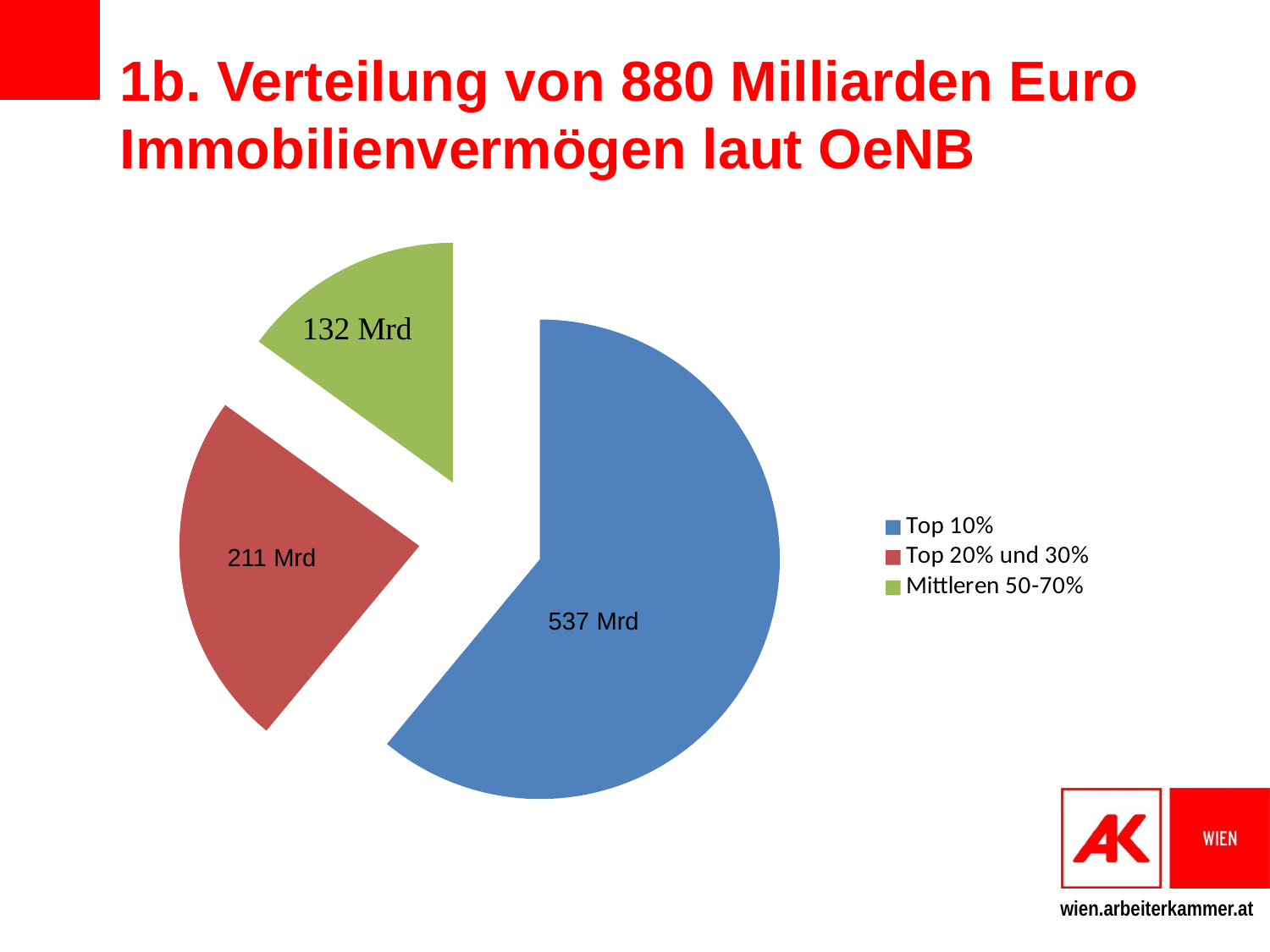
What value is shown for the Top 20% und 30% slice? 211 Mrd Which colour represents Top 10% in the legend? blue What value is shown for the Mittleren 50-70% slice? 132 Mrd What value is shown for the Top 10% slice? 537 Mrd Which is larger, the value for Top 20% und 30% or the value for Mittleren 50-70%? Top 20% und 30% How many slices does the pie chart have? 3 Which category has the smallest slice of the pie? Mittleren 50-70% What share of the total pie does the Mittleren 50-70% slice represent? 15% What is the difference between the Top 10% value and the Top 20% und 30% value? 326 Mrd What is the difference between the Top 20% und 30% value and the Mittleren 50-70% value? 79 Mrd What kind of chart is shown on the slide? pie chart Which category has the largest slice of the pie? Top 10%